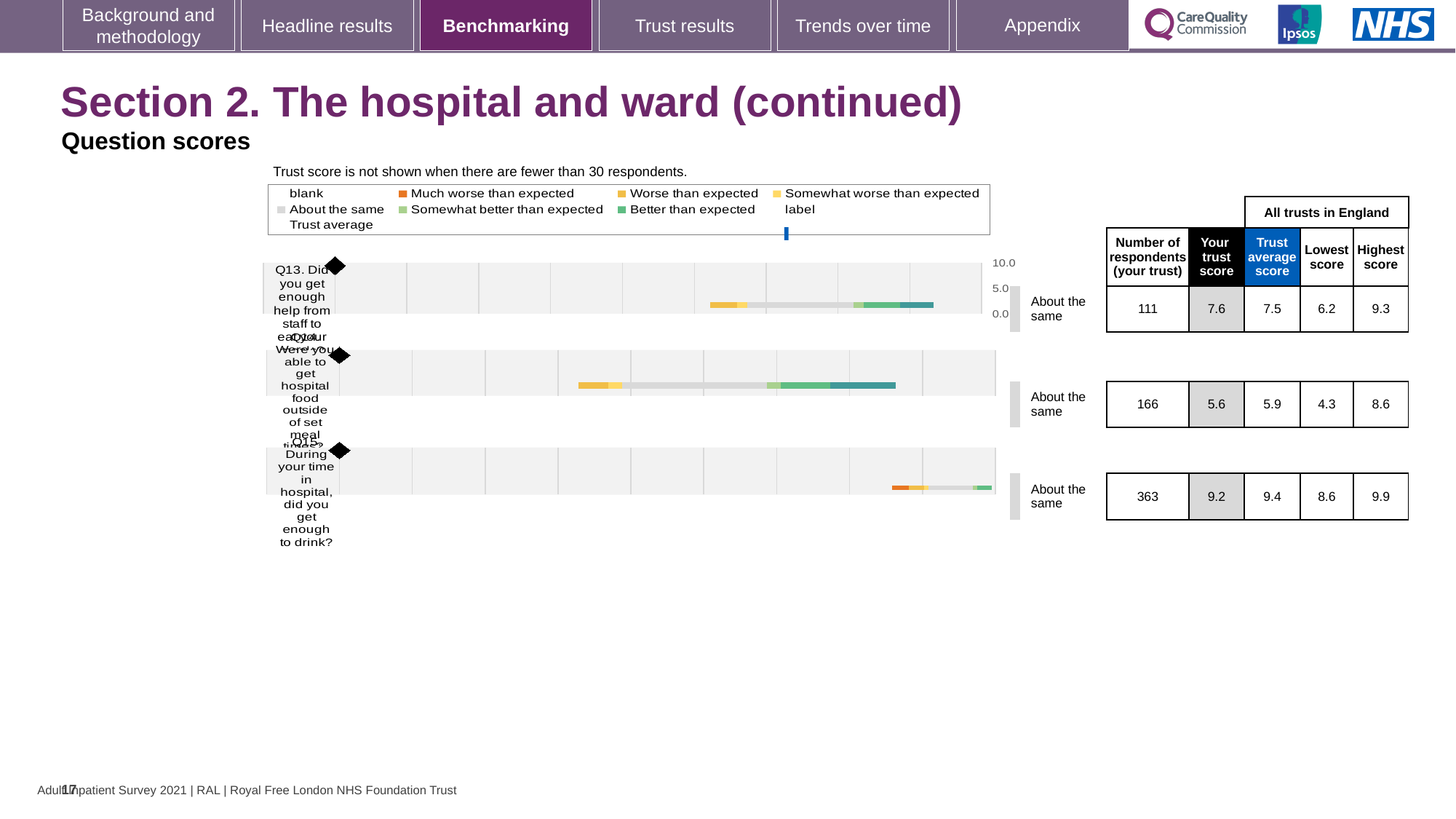
How many survey questions are plotted in the chart? 3 What is the highest score among all trusts in England for Q15? 9.9 Which question has the fewest respondents at this trust? Q13 What is the trust average score across all trusts in England for Q14? 5.9 What kind of chart is used to show the question scores? Bar chart What is the trust score for Q14 (Were you able to get hospital food outside of set meal times?)? 5.6 What is the trust score for Q13 (Did you get enough help from staff to eat your meals?)? 7.6 What benchmark category is shown for Q13, Q14 and Q15? About the same What is the difference between the highest score and the lowest score for Q15? 1.3 How many respondents answered Q15 (did you get enough to drink?) at this trust? 363 Which question has the highest trust score for this trust? Q15 For Q14, which is larger: this trust's score or the trust average score? Trust average score